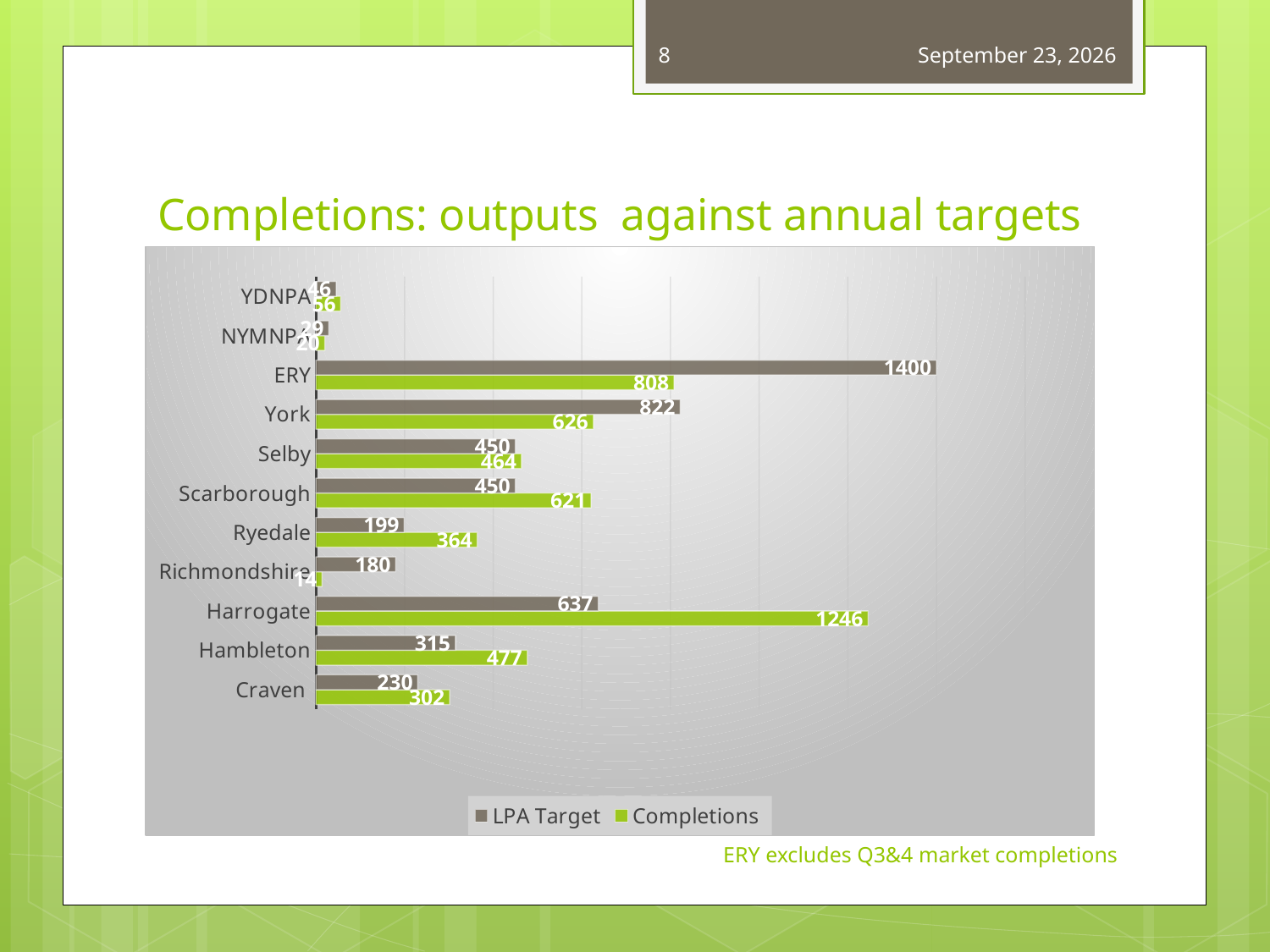
How many series does the legend list? 2 What is the Completions value for Harrogate? 1246 What kind of chart is shown on the slide? Bar chart Which category has the highest LPA Target? ERY Which category has the highest Completions value? Harrogate What is the Completions value for York? 626 What is the LPA Target value for ERY? 1400 How many categories are shown on the chart? 11 For Scarborough, which is larger: the LPA Target or Completions? Completions By how much do Completions exceed the LPA Target for Harrogate? 609 What is the LPA Target value for Ryedale? 199 What is the difference between the LPA Target and Completions for ERY? 592